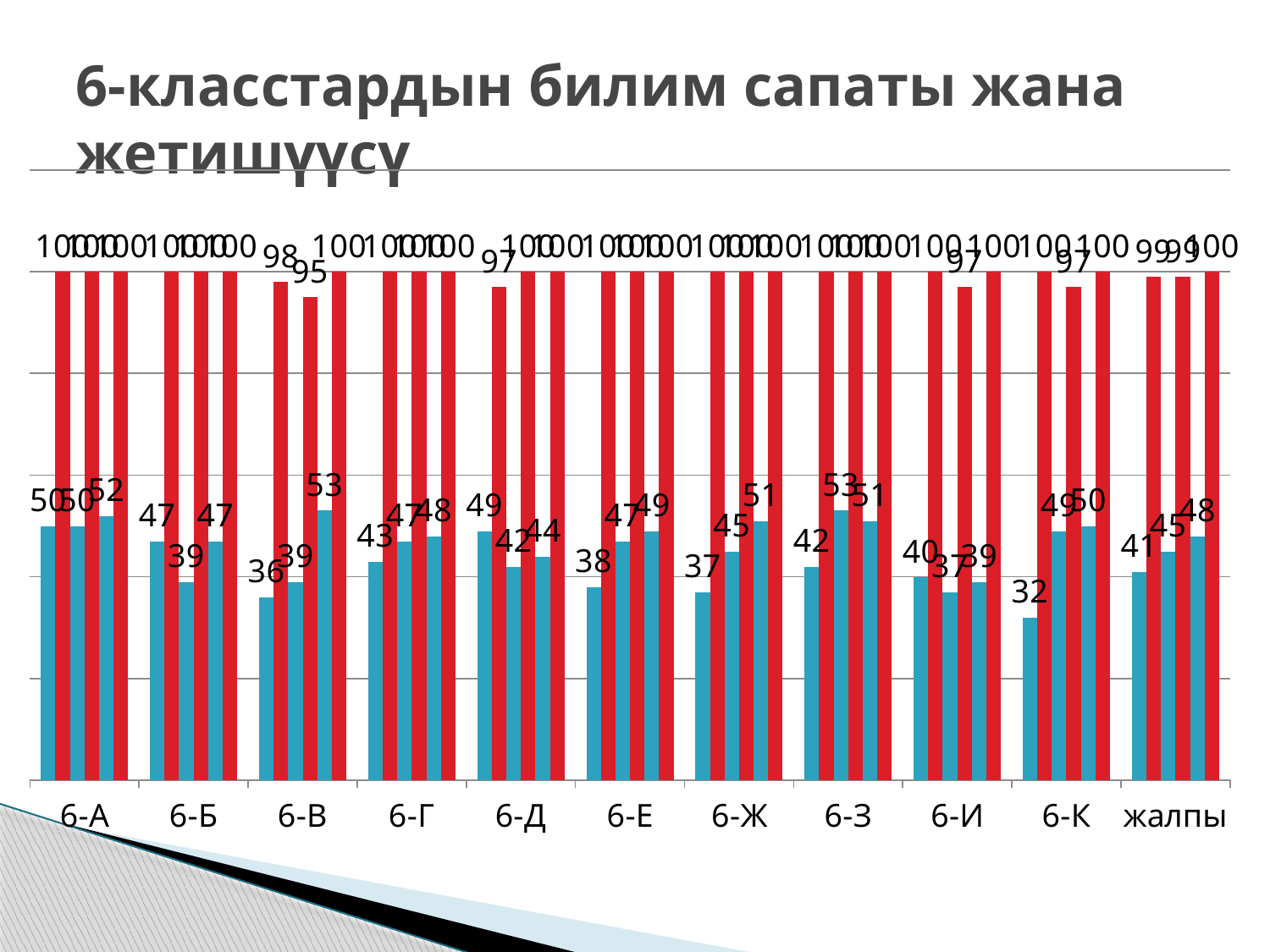
Which is larger: the second blue bar for 6-З or the second blue bar for 6-И? 6-З What is the value of the second red bar for 6-В? 95 How many categories are shown along the x axis of the chart? 11 What is the difference between the third blue bar (52) and the first blue bar (50) for 6-А? 2 What is the value of the third blue bar for 6-В? 53 Which category has the lowest red bar value in the chart? 6-В Which category has the lowest blue bar value in the chart? 6-К What is the value of the first blue bar for жалпы? 41 What is the value of the first blue bar for 6-К? 32 What is the title of the chart on the slide? 6-класстардын билим сапаты жана жетишүүсү What kind of chart is shown on the slide? bar chart What two colours are used for the bars in the chart? blue and red